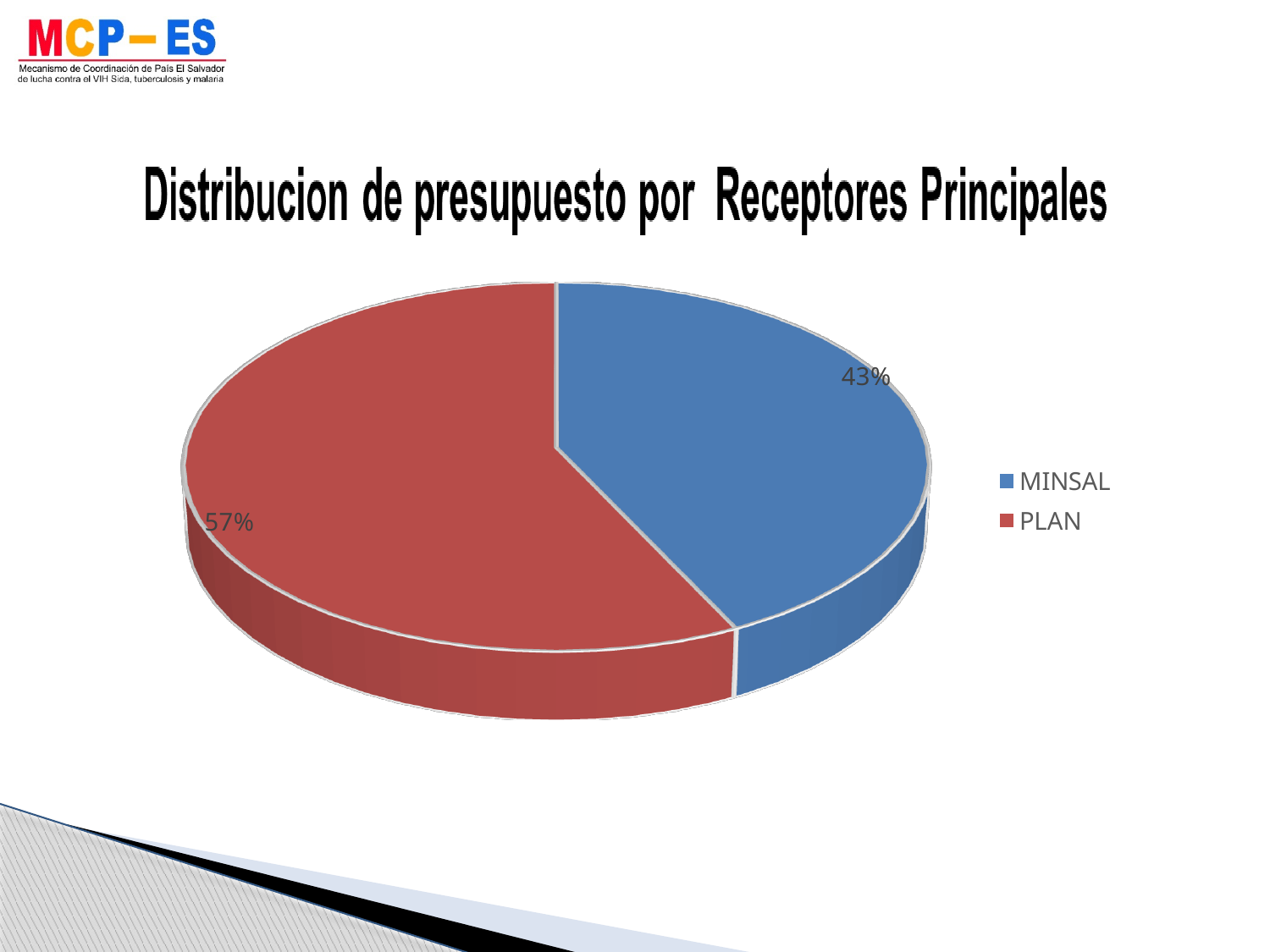
Which category has the smallest slice of the pie? MINSAL What is the title of the chart? Distribucion de presupuesto por Receptores Principales What share of the pie does MINSAL have? 43% What colour is the MINSAL slice? blue Which category has the largest slice of the pie? PLAN How many entries does the legend list? 2 How many categories does the pie chart show? 2 What is the difference in percentage points between the PLAN share and the MINSAL share? 14% What kind of chart is shown on the slide? pie chart Which is larger, the share for PLAN or the share for MINSAL? PLAN What share of the pie does PLAN have? 57%